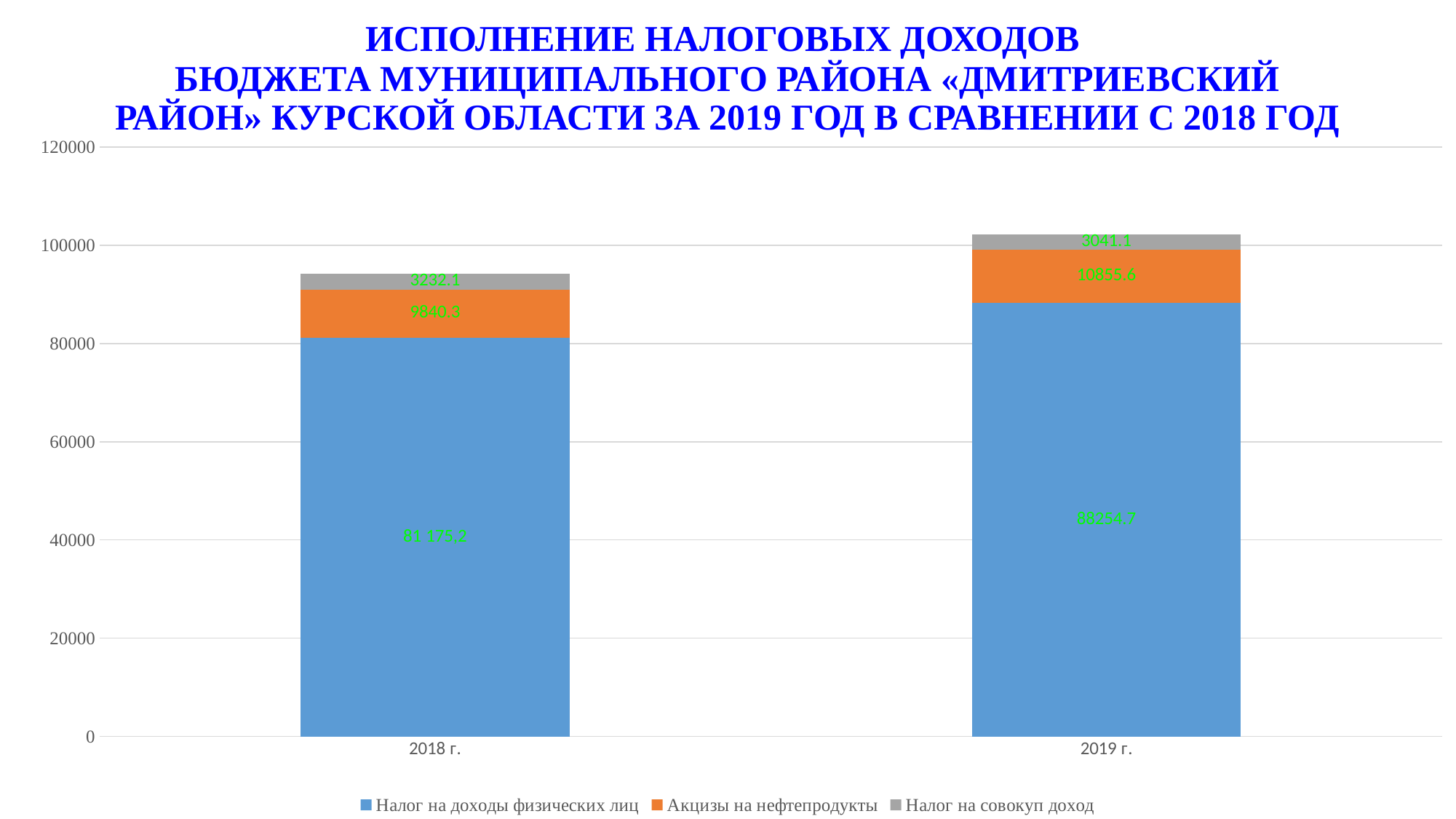
What is the value of Налог на совокуп доход for 2018 г.? 3232.1 How many categories (years) are shown on the x axis? 2 By how much did Акцизы на нефтепродукты increase from 2018 г. to 2019 г.? 1015.3 Is the total of the stacked bar for 2018 г. greater or less than 100000? less What is the value of Налог на доходы физических лиц for 2018 г.? 81 175,2 What is the value of Акцизы на нефтепродукты for 2019 г.? 10855.6 Which year has the larger value for Налог на совокуп доход, 2018 г. or 2019 г.? 2018 г. How many series does the legend list? 3 Which series is shown in orange in the legend? Акцизы на нефтепродукты What is the total height of the stacked bar for 2019 г.? 102151.4 What is the value of Налог на доходы физических лиц for 2019 г.? 88254.7 What kind of chart is shown on the slide? Stacked bar chart